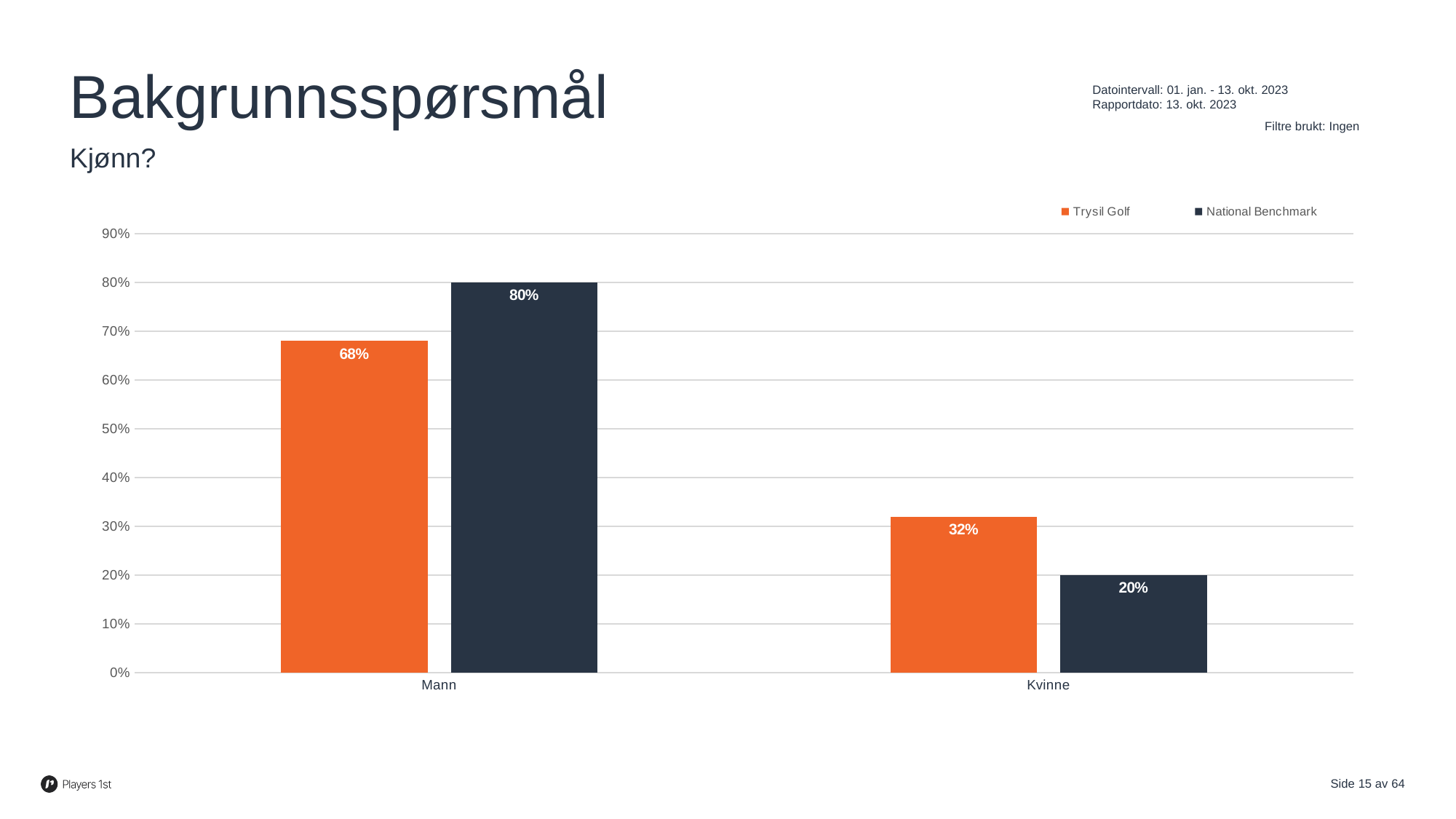
What is the value for Trysil Golf in the Mann category? 68% What is the value for Trysil Golf in the Kvinne category? 32% Which category has the highest value for National Benchmark? Mann How many categories are shown on the x axis? 2 What is the value for National Benchmark in the Kvinne category? 20% What is the difference between National Benchmark and Trysil Golf in the Mann category? 12% In the Kvinne category, which series has the larger value, Trysil Golf or National Benchmark? Trysil Golf Which category has the lowest value for Trysil Golf? Kvinne What is the difference between Trysil Golf and National Benchmark in the Kvinne category? 12% How many series does the legend list? 2 What is the value for National Benchmark in the Mann category? 80% What kind of chart is shown on the slide? Bar chart